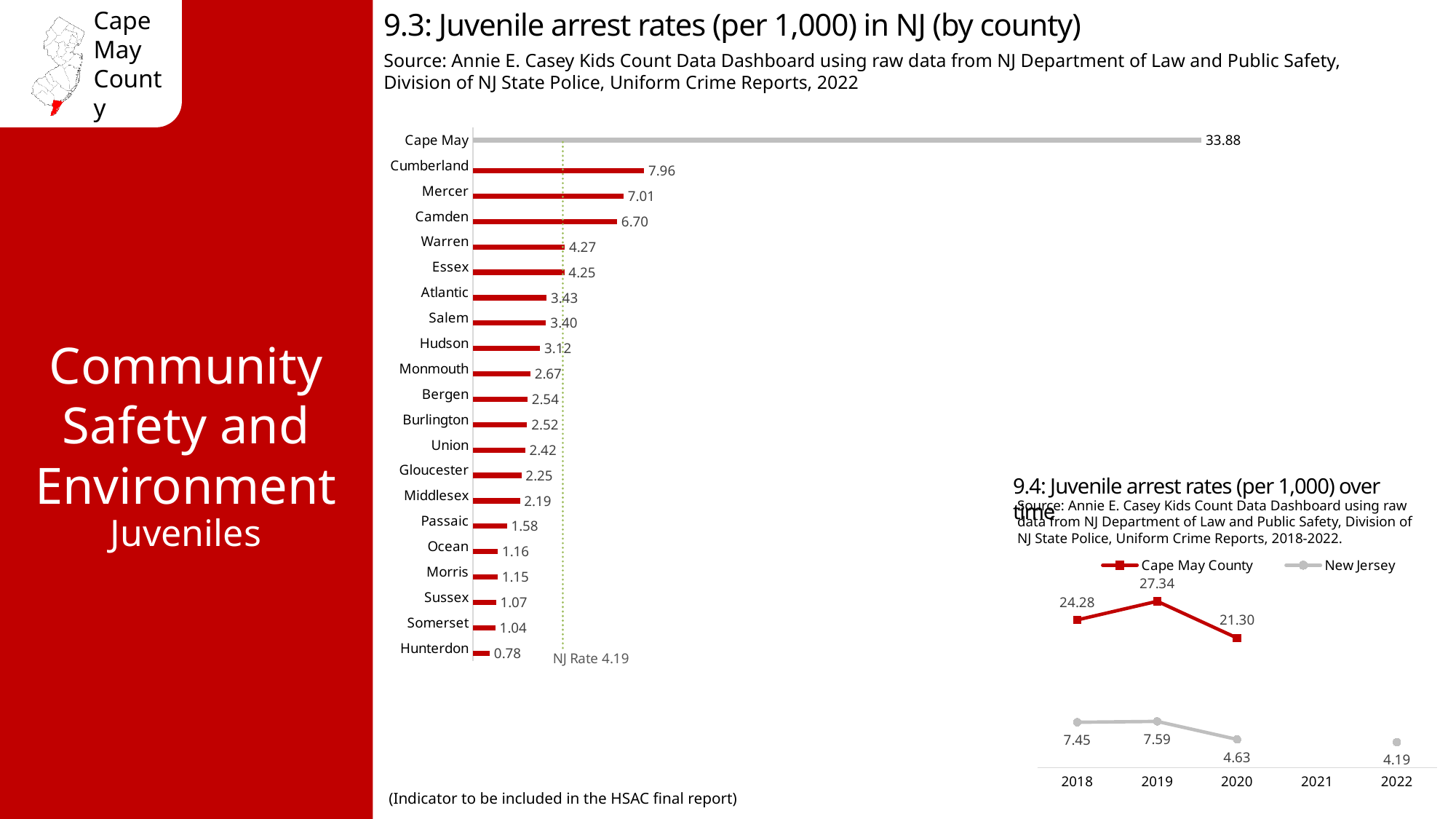
In chart 9.3 (juvenile arrest rates by county), which is larger, the value for Camden or the value for Warren? Camden In chart 9.4 (juvenile arrest rates over time), what is the difference between the Cape May County and New Jersey values in 2020? 16.67 In chart 9.4 (juvenile arrest rates over time), what is the New Jersey value for 2022? 4.19 What kind of chart is chart 9.3 (juvenile arrest rates by county)? Bar chart In chart 9.4 (juvenile arrest rates over time), how many series does the legend list? 2 In chart 9.3 (juvenile arrest rates by county), what is the value for Cape May? 33.88 In chart 9.3 (juvenile arrest rates by county), what NJ rate is marked by the dotted reference line? 4.19 In chart 9.3 (juvenile arrest rates by county), how many counties are shown? 21 In chart 9.3 (juvenile arrest rates by county), which county has the lowest rate? Hunterdon In chart 9.4 (juvenile arrest rates over time), what is the Cape May County value for 2019? 27.34 In chart 9.3 (juvenile arrest rates by county), what is the difference between Cumberland and Mercer? 0.95 In chart 9.3 (juvenile arrest rates by county), which county has the highest rate? Cape May